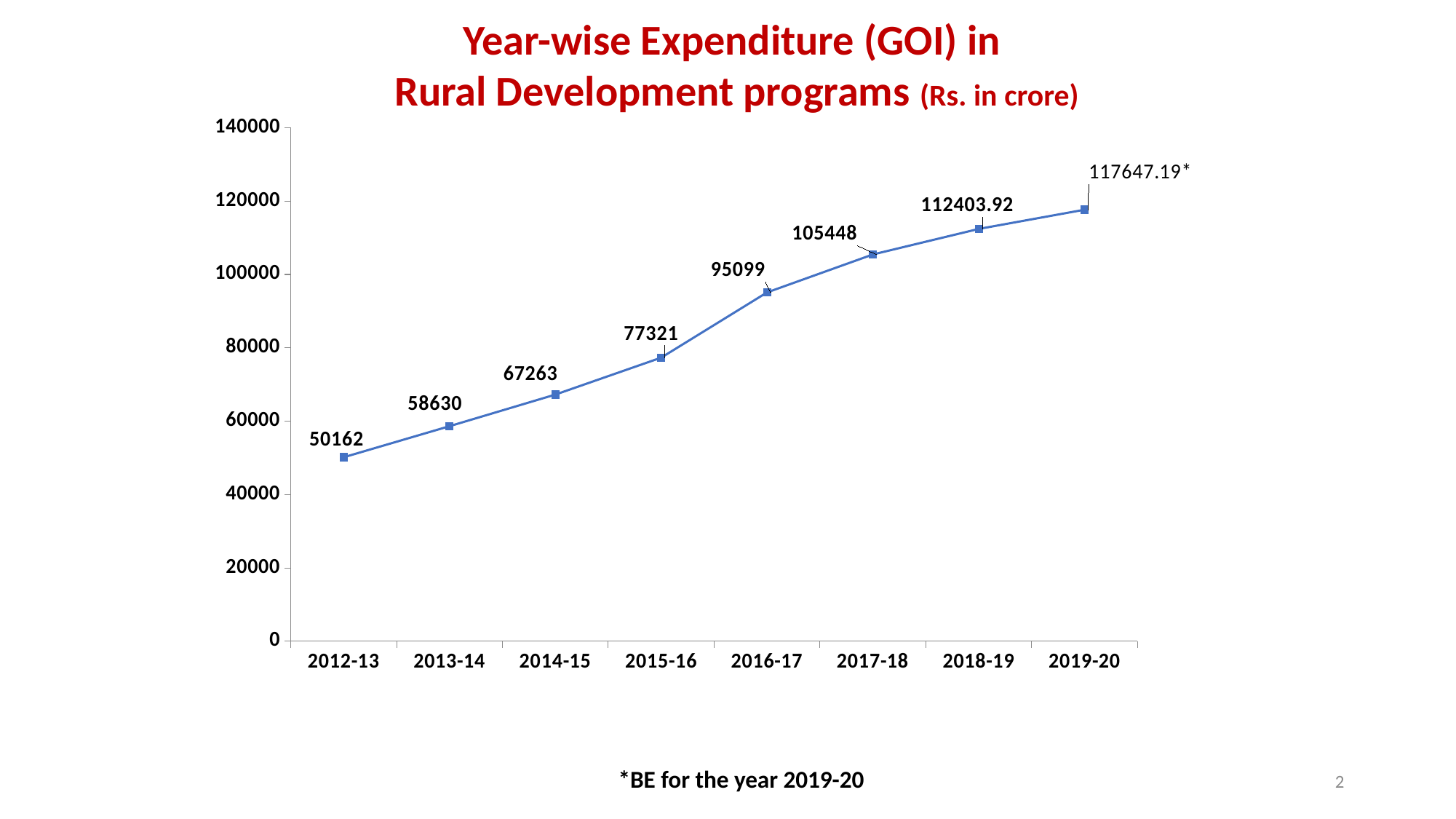
What is the expenditure for 2018-19? 112403.92 Which year has the highest expenditure? 2019-20 How many years are plotted on the chart? 8 Which is larger, the expenditure for 2013-14 or for 2014-15? 2014-15 Is the value for 2017-18 greater or less than 100000? greater What kind of chart is shown on the slide? line chart Do the values rise or fall from 2012-13 to 2019-20? rise What is the expenditure for 2019-20? 117647.19 Which year has the lowest expenditure? 2012-13 What is the expenditure for 2012-13? 50162 What is the difference in expenditure between 2015-16 and 2014-15? 10058 What is the expenditure for 2016-17? 95099